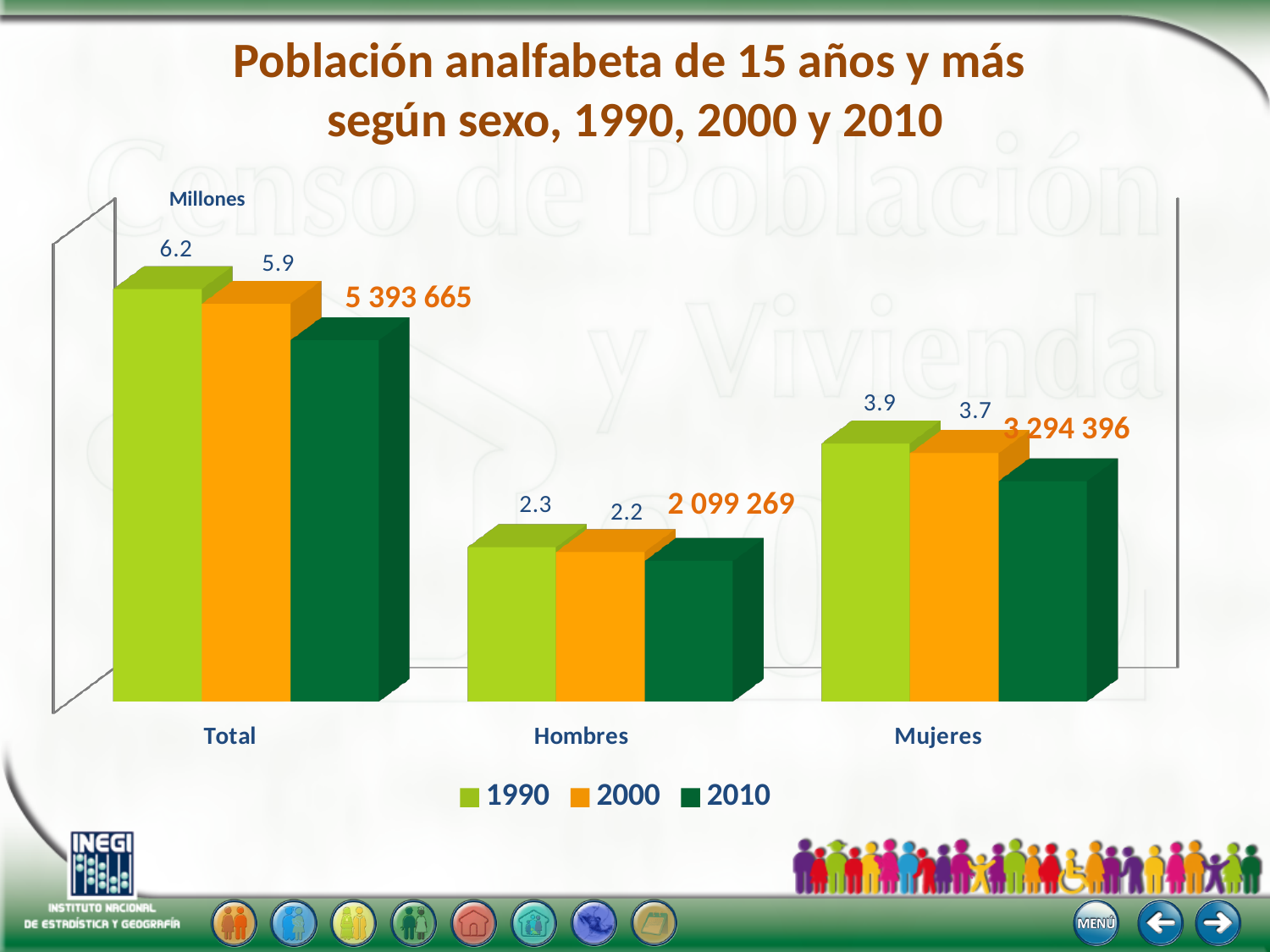
What is the value for Hombres in 2000? 2.2 What is the value for Mujeres in 1990? 3.9 Which is larger, the 1990 value for Mujeres or the 1990 value for Hombres? Mujeres Which category has the lowest value in 2000? Hombres What is the value for Total in 2010? 5 393 665 How many series does the legend list? 3 What is the value for Total in 1990? 6.2 How many categories are shown on the x axis? 3 Which category has the highest value in 1990? Total What is the difference between the Total values for 1990 and 2000? 0.3 What is the value for Mujeres in 2010? 3 294 396 What type of chart is shown on the slide? bar chart